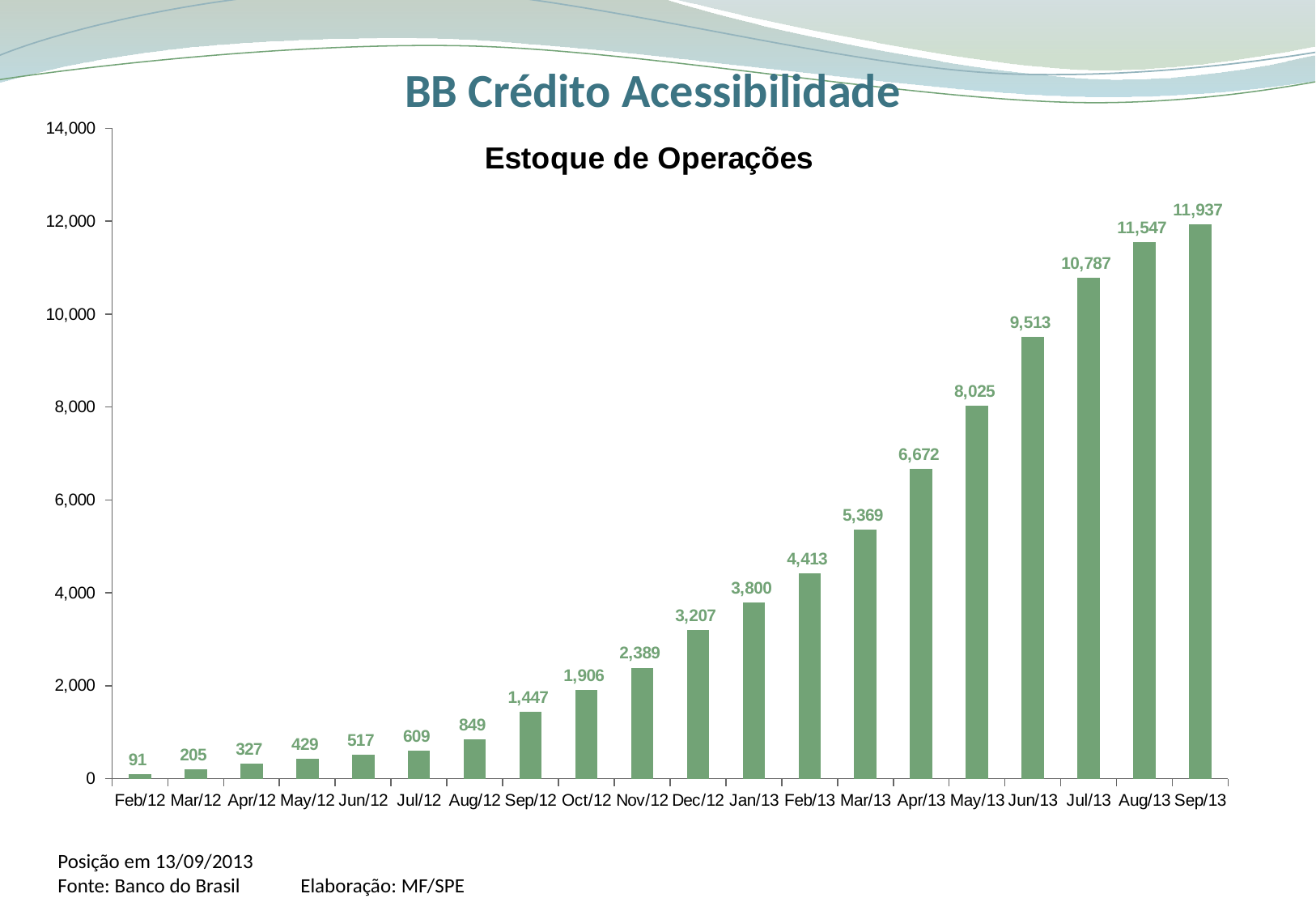
Do the values rise or fall from Feb/12 to Sep/13? rise What is the value for Dec/12? 3,207 Which month has the lowest value? Feb/12 Which month has the highest value? Sep/13 How many months are shown on the x axis? 20 What kind of chart is shown? bar chart What is the value for Feb/12? 91 Is the value for Jun/13 greater or less than 10,000? less What is the value for Sep/13? 11,937 What is the difference between the values for Sep/13 and Aug/13? 390 What is the difference between the values for Jan/13 and Dec/12? 593 Which is larger, the value for Mar/13 or the value for Apr/13? Apr/13